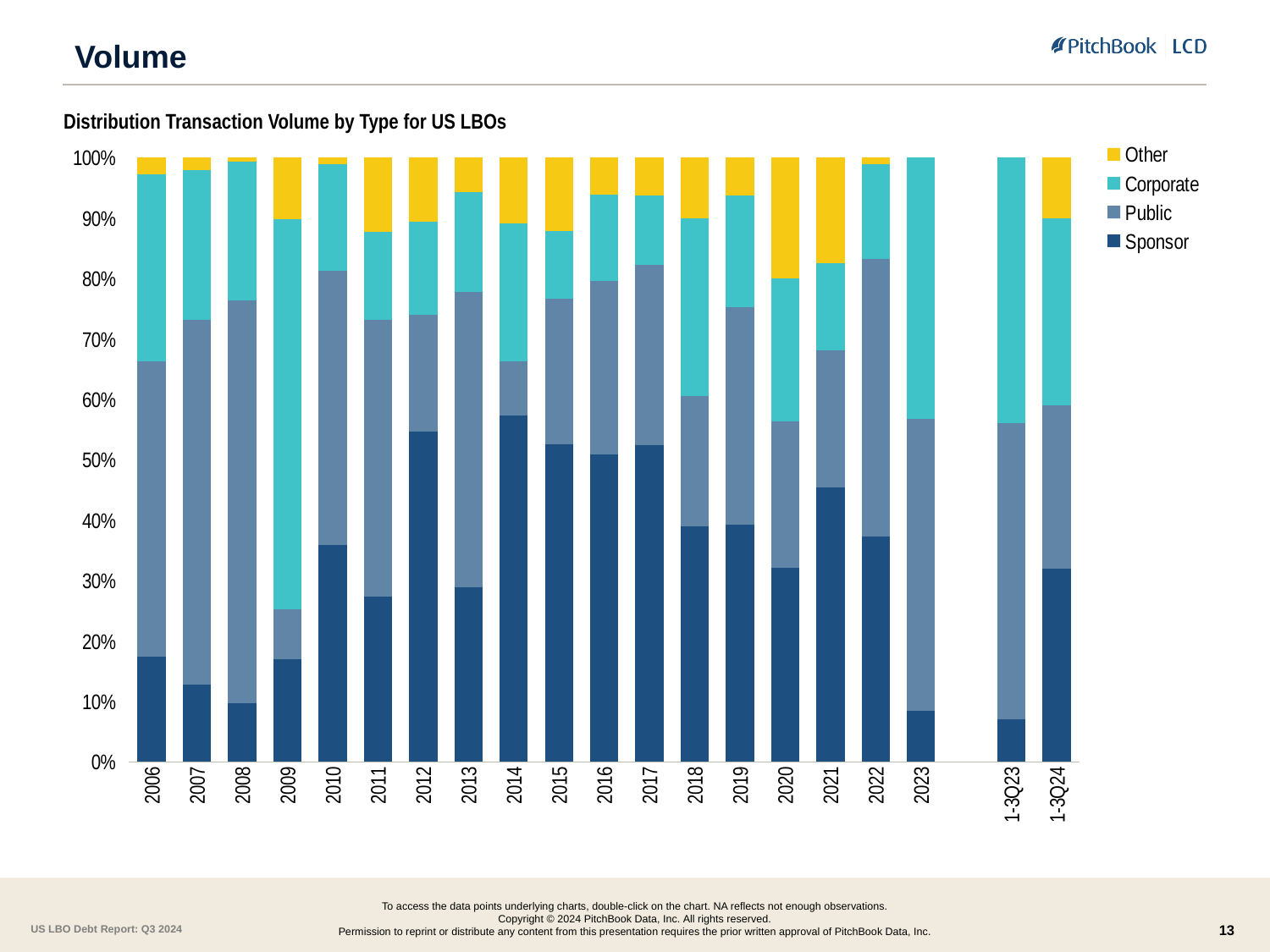
Which series is shown in yellow in the legend? Other Is the Sponsor share for 2020 greater or less than 30%? greater What kind of chart is shown on the slide? Stacked bar chart How many series does the legend list? 4 Is the Sponsor share for 2021 greater or less than 50%? less Which year has the largest Other segment? 2020 Which is larger, the Sponsor share in 2014 or in 2006? 2014 Is the Sponsor share for 2023 greater or less than 10%? less How many categories are shown along the x axis? 20 Which year has the largest Corporate segment? 2009 What is the title of the chart? Distribution Transaction Volume by Type for US LBOs